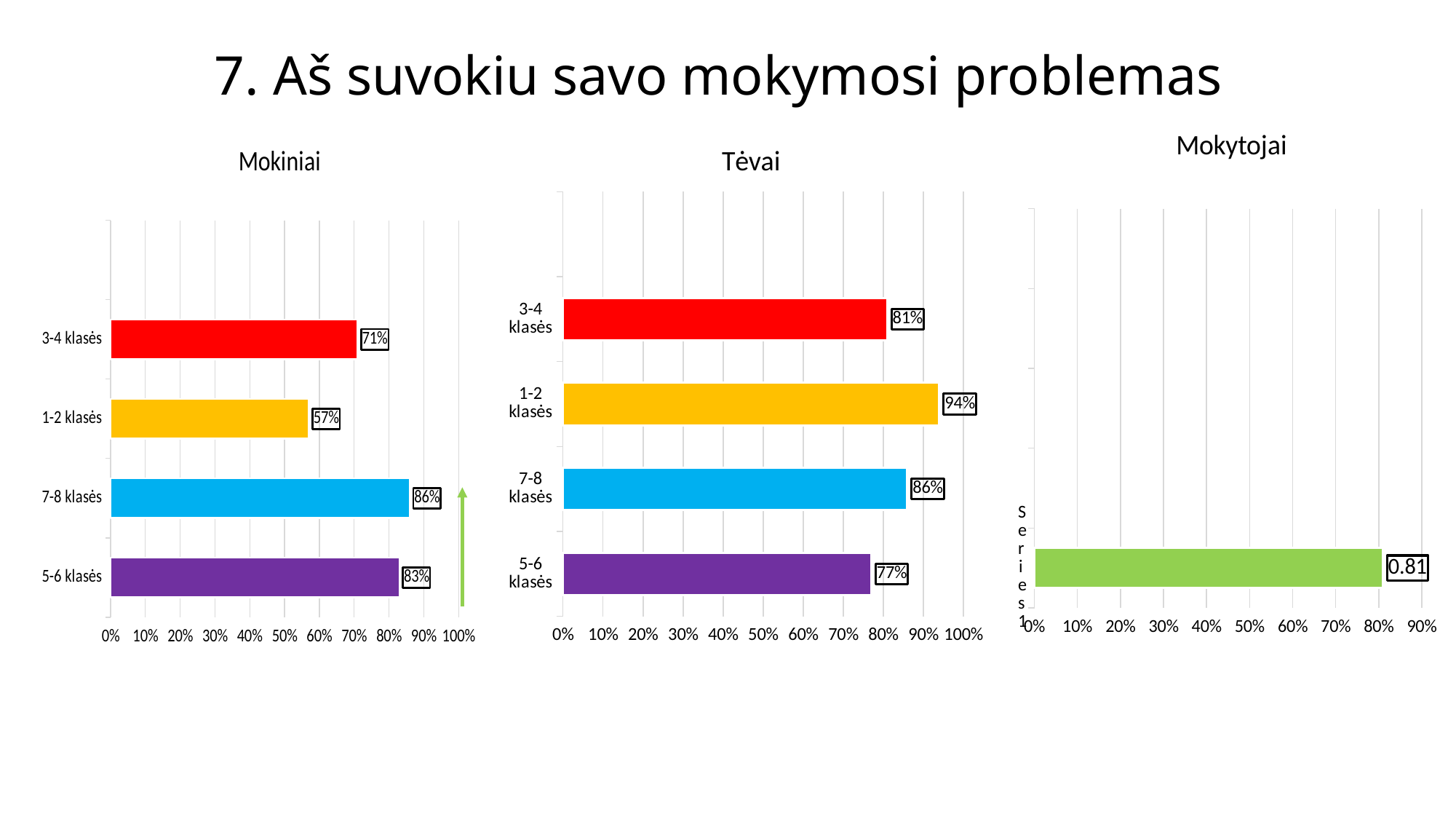
In the Mokiniai chart, which category has the highest value? 7-8 klasės In the Mokiniai chart, which category has the lowest value? 1-2 klasės In the Mokytojai chart, what is the value shown on the bar's data label? 0.81 In the Tėvai chart, what is the value for 1-2 klasės? 94% In the Tėvai chart, which is larger, the value for 3-4 klasės or the value for 7-8 klasės? 7-8 klasės In the Tėvai chart, which category has the lowest value? 5-6 klasės In the Tėvai chart, what is the difference between the values for 1-2 klasės and 5-6 klasės? 17% How many categories does the Tėvai chart show? 4 In the Mokiniai chart, what is the difference between the values for 7-8 klasės and 1-2 klasės? 29% In the Mokiniai chart, what is the value for 3-4 klasės? 71% What kind of chart is the Mokytojai chart? bar chart What is the title of the chart on the left of the slide? Mokiniai